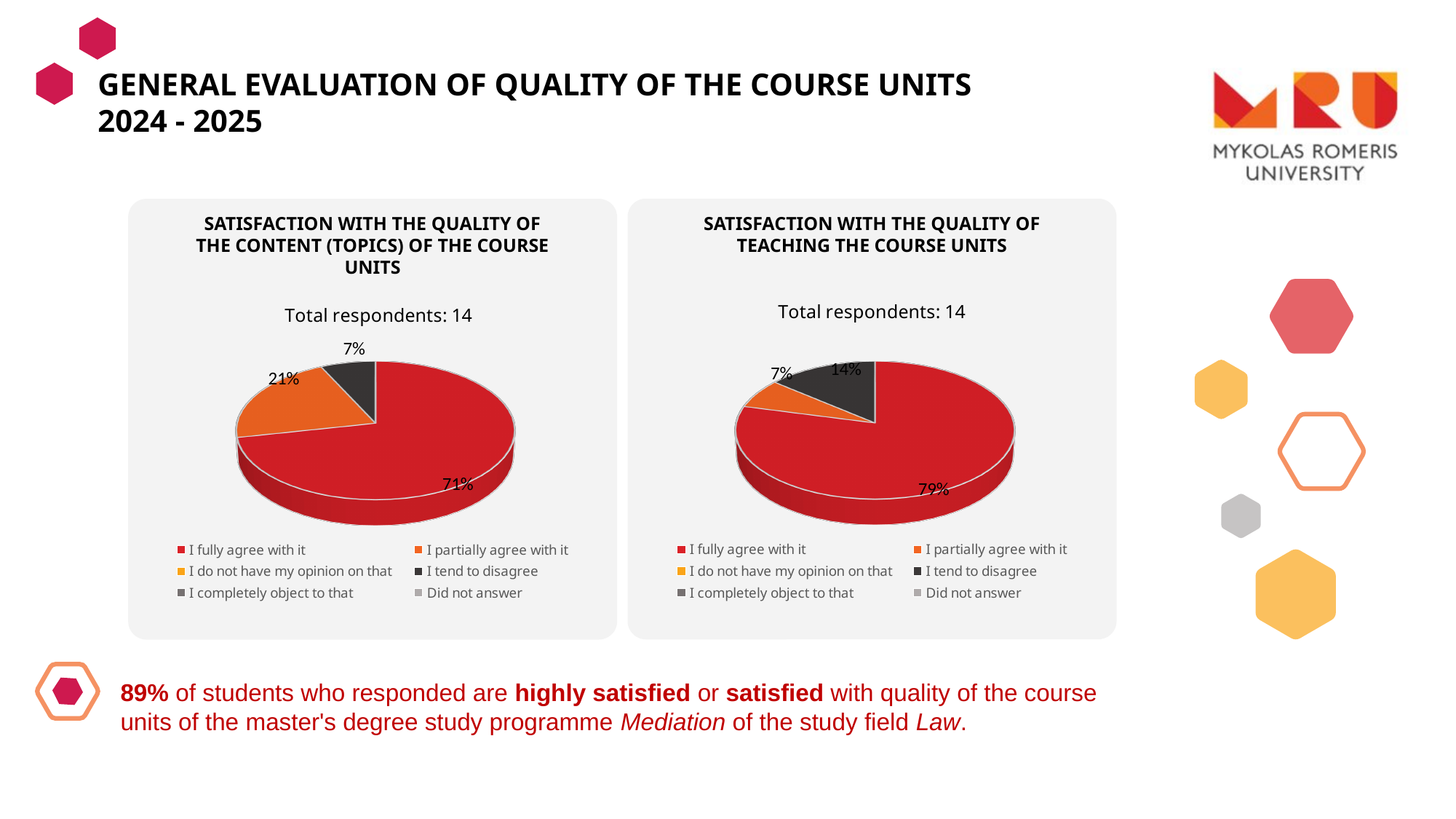
What type of chart is used on this slide? Pie chart In the left chart (satisfaction with the quality of the content of the course units), what share of respondents chose "I tend to disagree"? 7% In the right chart (satisfaction with the quality of teaching the course units), what share of respondents chose "I tend to disagree"? 14% What is the difference between the "I fully agree with it" share in the right chart (teaching) and in the left chart (content)? 8 percentage points How many entries does the legend of the left chart (satisfaction with the quality of the content of the course units) list? 6 In the left chart (satisfaction with the quality of the content of the course units), what share of respondents chose "I fully agree with it"? 71% In the right chart (satisfaction with the quality of teaching the course units), which response has the smallest slice? I partially agree with it Which chart has the larger "I partially agree with it" share: the left chart (content) or the right chart (teaching)? The left chart (content) In the right chart (satisfaction with the quality of teaching the course units), what share of respondents chose "I partially agree with it"? 7% In the left chart (satisfaction with the quality of the content of the course units), which response has the largest slice? I fully agree with it In the right chart (satisfaction with the quality of teaching the course units), what share of respondents chose "I fully agree with it"? 79% In the left chart (satisfaction with the quality of the content of the course units), what share of respondents chose "I partially agree with it"? 21%